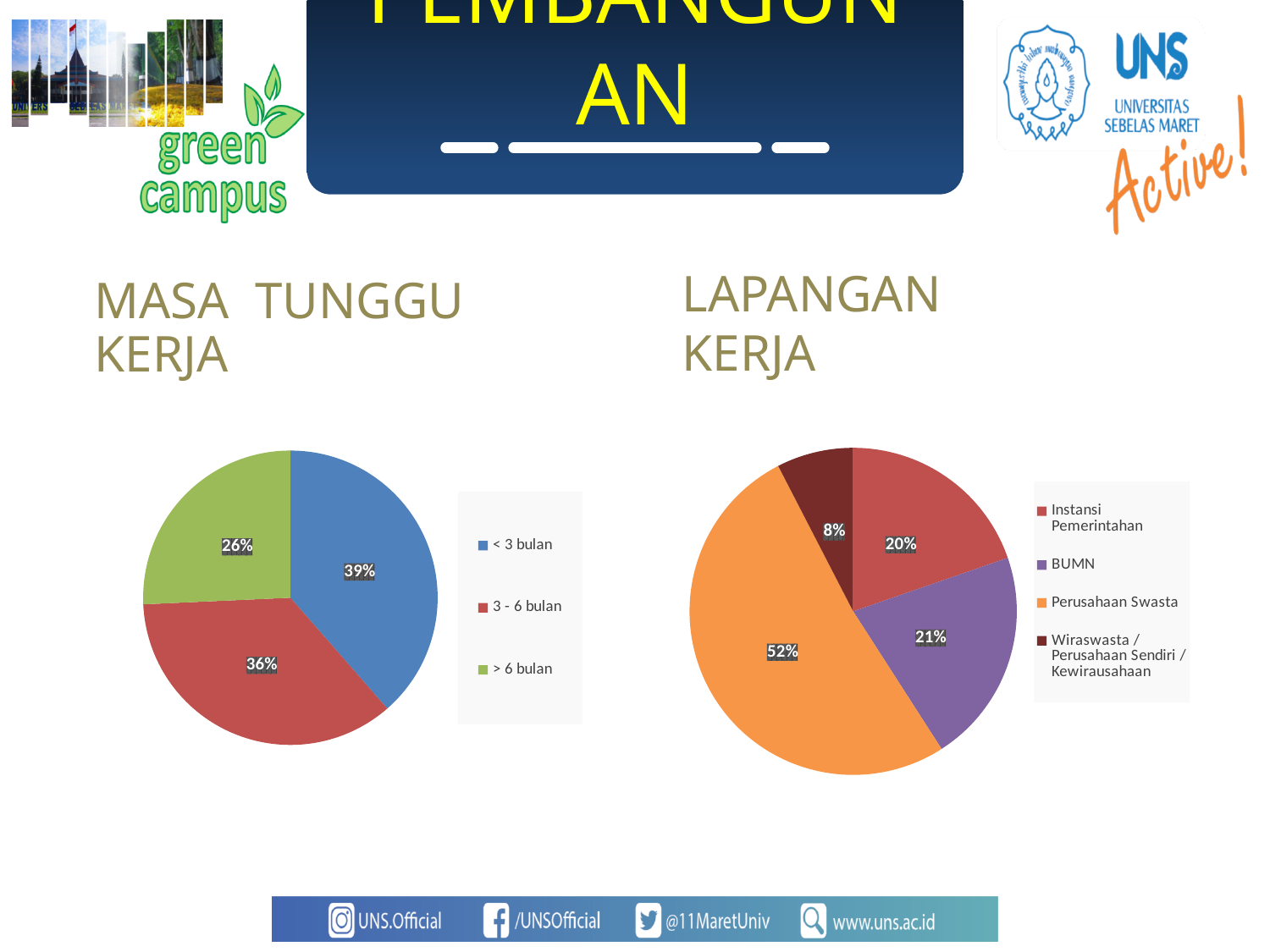
In the MASA TUNGGU KERJA pie chart, what is the difference between the shares for '3 - 6 bulan' and '> 6 bulan'? 10% In the MASA TUNGGU KERJA pie chart, which category has the largest share? < 3 bulan In the MASA TUNGGU KERJA pie chart, what percentage is shown for '> 6 bulan'? 26% In the LAPANGAN KERJA pie chart, what percentage is shown for 'Perusahaan Swasta'? 52% In the LAPANGAN KERJA pie chart, what percentage is shown for 'BUMN'? 21% How many categories does the MASA TUNGGU KERJA pie chart have? 3 In the LAPANGAN KERJA pie chart, which is larger, 'Instansi Pemerintahan' or 'BUMN'? BUMN How many categories does the LAPANGAN KERJA pie chart have? 4 In the MASA TUNGGU KERJA pie chart, what percentage is shown for '< 3 bulan'? 39% In the LAPANGAN KERJA pie chart, which category has the smallest share? Wiraswasta / Perusahaan Sendiri / Kewirausahaan In the MASA TUNGGU KERJA pie chart, which category has the smallest share? > 6 bulan What type of chart is used for LAPANGAN KERJA? Pie chart